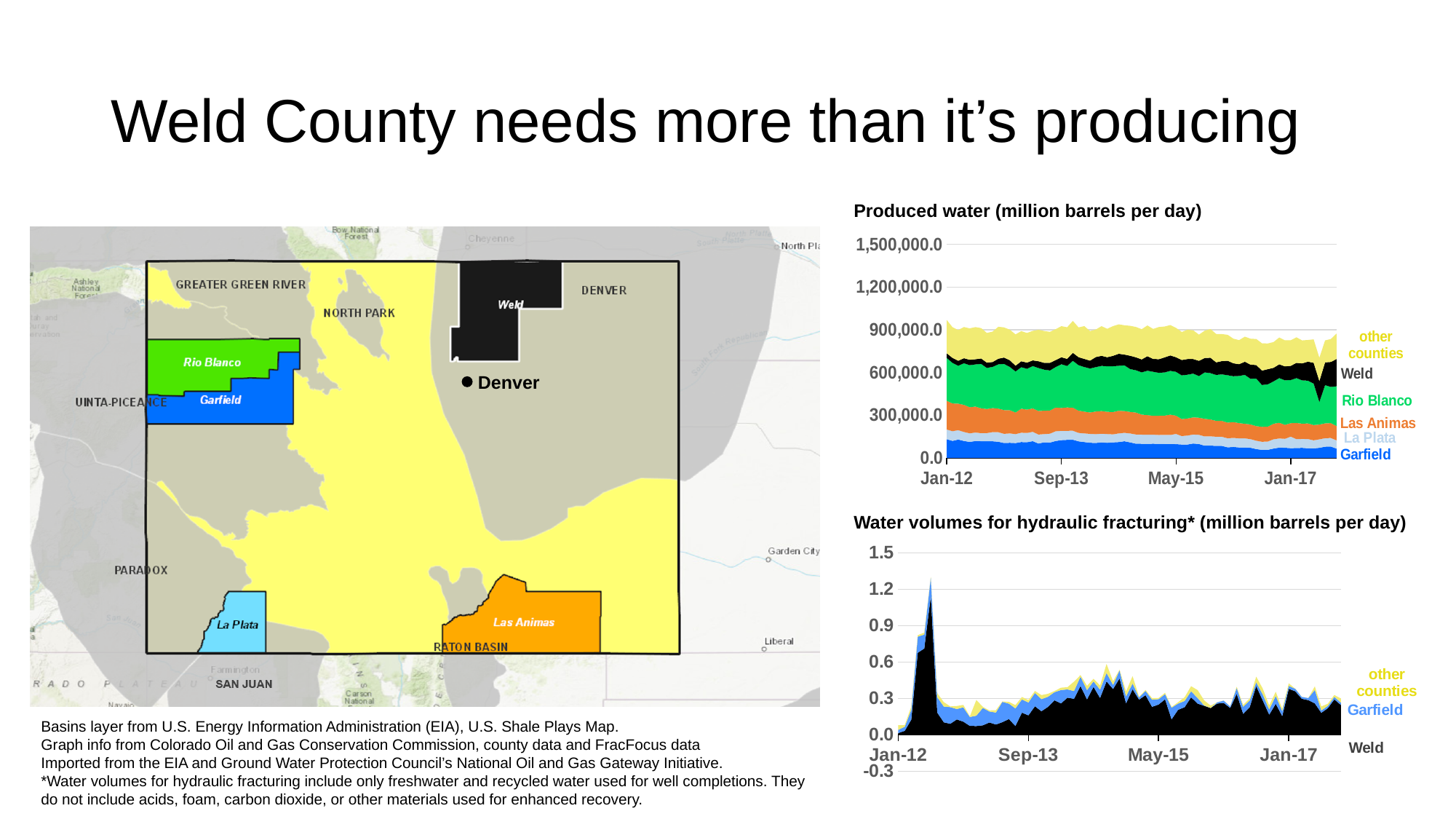
What is the title of the upper chart on the right side of the slide? Produced water (million barrels per day) In the 'Produced water (million barrels per day)' chart, which series forms the largest band? Rio Blanco What kind of chart is the 'Produced water (million barrels per day)' chart? Stacked area chart In the 'Produced water (million barrels per day)' chart, which series is the thinnest band (smallest contribution)? La Plata How many series does the legend of the 'Water volumes for hydraulic fracturing* (million barrels per day)' chart list? 3 In the 'Water volumes for hydraulic fracturing* (million barrels per day)' chart, is the peak total value in early 2012 greater or less than 0.9? greater In the 'Water volumes for hydraulic fracturing* (million barrels per day)' chart, which series accounts for the largest share of the stacked area? Weld How many series does the legend of the 'Produced water (million barrels per day)' chart list? 6 In the 'Water volumes for hydraulic fracturing* (million barrels per day)' chart, is the total value at Jan-17 greater or less than 0.9? less In the 'Produced water (million barrels per day)' chart, what colour represents the Weld series? Black In the 'Produced water (million barrels per day)' chart, is the total stacked value at Jan-12 greater or less than 1,200,000.0? less